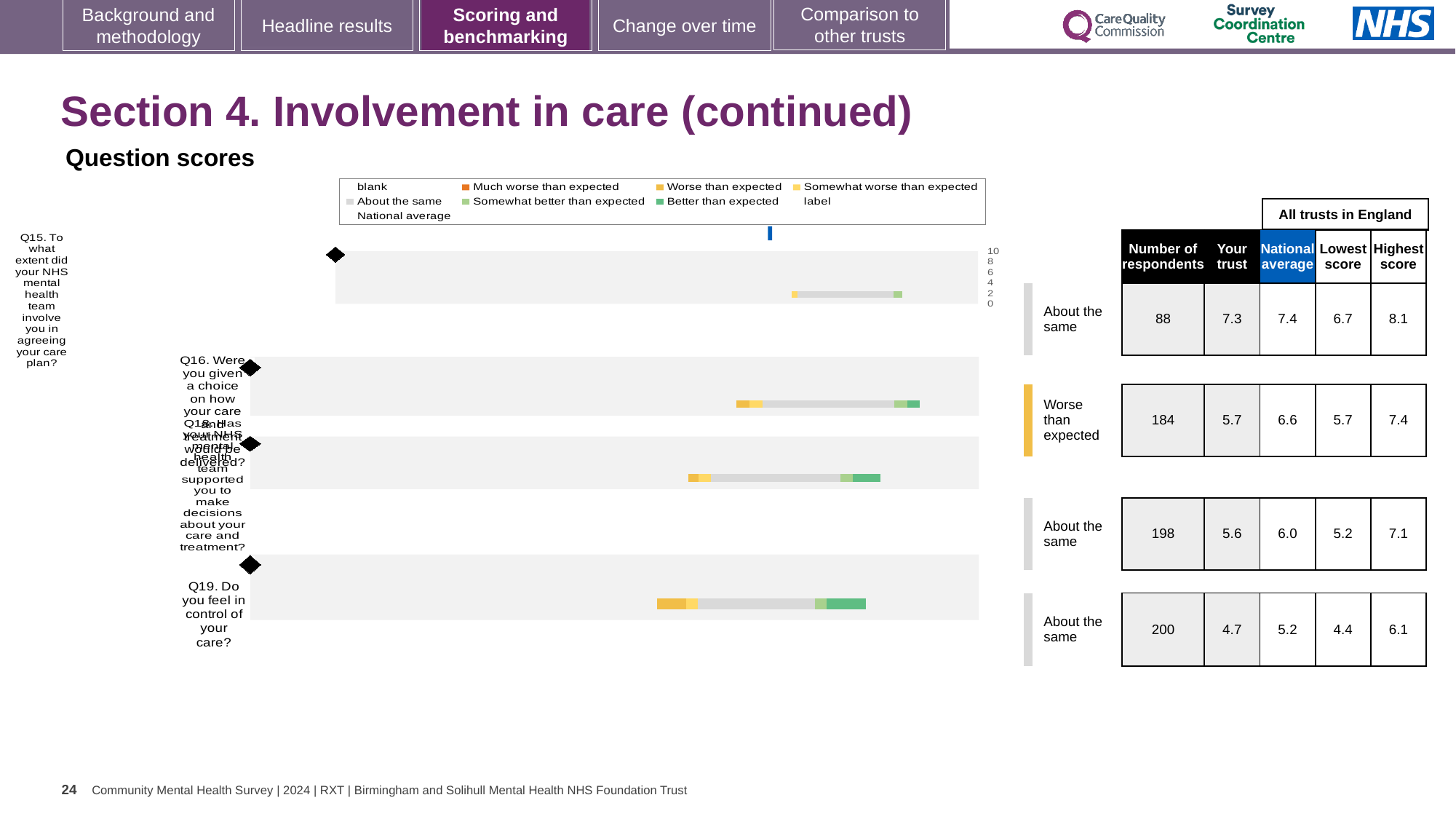
For Q15, which is larger: the 'Your trust' score or the national average? National average What is the highest score among all trusts in England for Q15? 8.1 How many respondents answered Q16 (Were you given a choice on how your care and treatment would be delivered?)? 184 What is the lowest score among all trusts in England for Q19? 4.4 What benchmark category is shown for Q16? Worse than expected How many questions are shown in the chart? 4 What kind of chart is used to show the question scores? Bar chart What is the national average score for Q19 (Do you feel in control of your care?)? 5.2 Which question has the highest 'Your trust' score? Q15 What is the 'Your trust' score for Q15 (To what extent did your NHS mental health team involve you in agreeing your care plan?)? 7.3 For Q16, how much higher is the national average than the 'Your trust' score? 0.9 Which question has the lowest 'Your trust' score? Q19